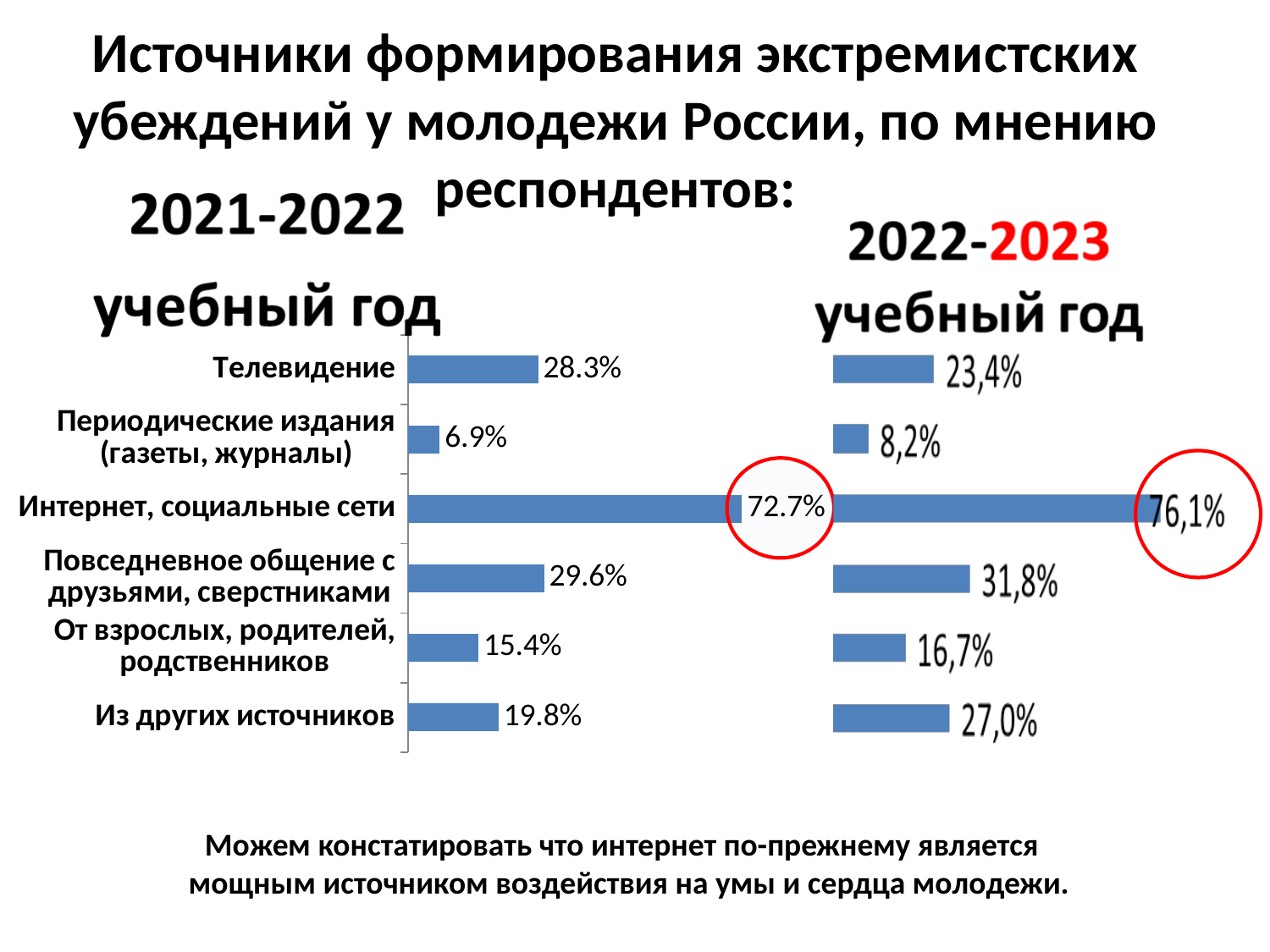
In the 2022-2023 учебный год chart, what is the value for Интернет, социальные сети? 76,1% In the 2022-2023 учебный год chart, what is the difference between the values for Повседневное общение с друзьями, сверстниками and От взрослых, родителей, родственников? 15,1% In the 2022-2023 учебный год chart, what is the value for Из других источников? 27,0% In the 2022-2023 учебный год chart, which category has the lowest value? Периодические издания (газеты, журналы) What kind of chart is the 2022-2023 учебный год chart? Bar chart How many categories are shown in the 2021-2022 учебный год chart? 6 In the 2021-2022 учебный год chart, what is the value for Телевидение? 28.3% In the 2021-2022 учебный год chart, what is the value for Периодические издания (газеты, журналы)? 6.9% Which category is highlighted with a red circle in both charts? Интернет, социальные сети In the 2022-2023 учебный год chart, which is larger: the value for Телевидение or the value for Из других источников? Из других источников In the 2021-2022 учебный год chart, which category has the highest value? Интернет, социальные сети In the 2021-2022 учебный год chart, what is the difference between the values for Повседневное общение с друзьями, сверстниками and Телевидение? 1.3%